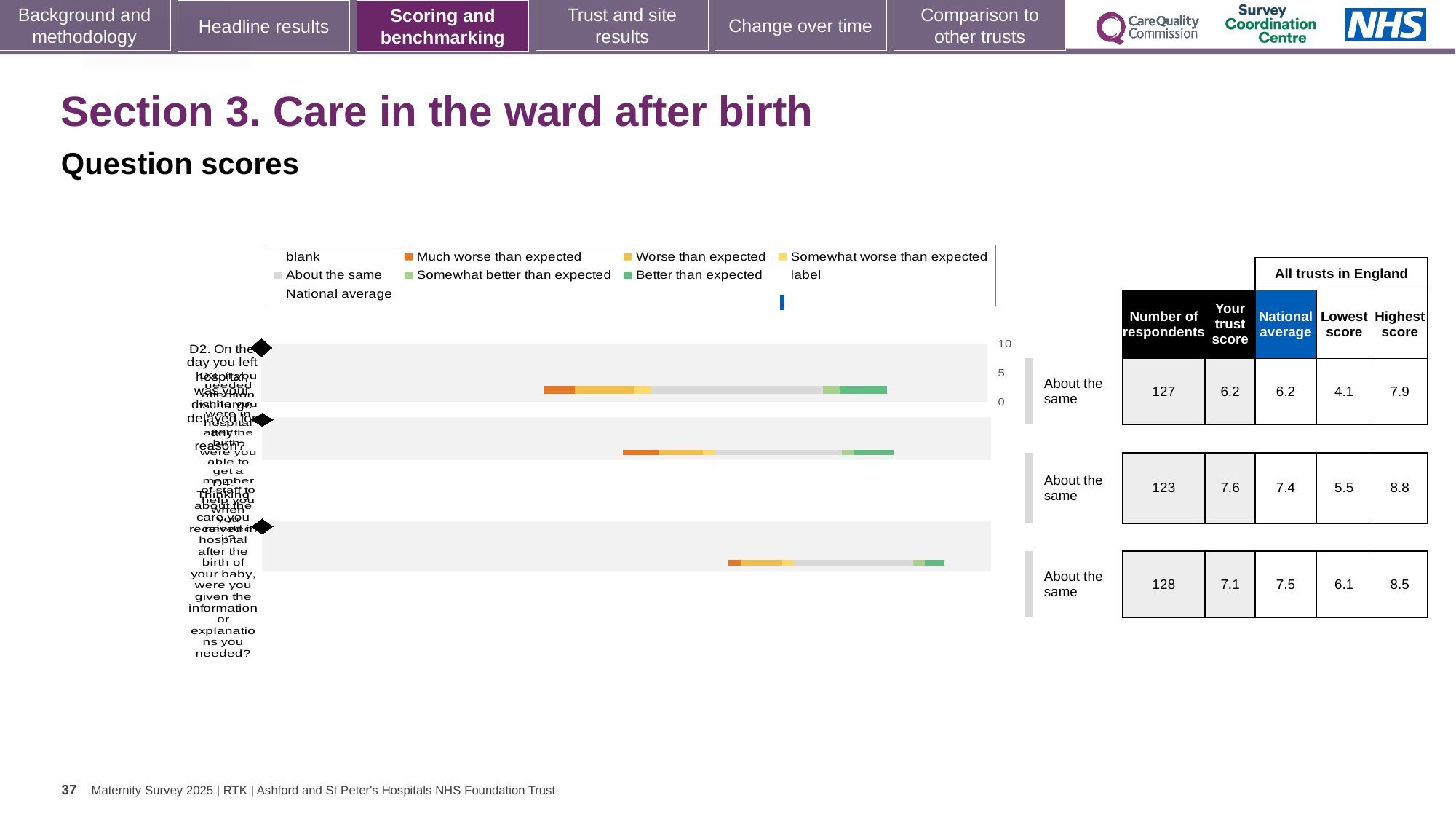
What type of chart is shown on the slide? bar chart Which row in the table beside the chart has the highest 'Highest score' value? middle row (8.8) For the middle row in the table beside the chart, which is larger: the trust score or the national average? trust score (7.6) Which row in the table beside the chart has the lowest 'Lowest score' value? top row (4.1) In the table beside the chart, what is the national average for the bottom row? 7.5 In the table beside the chart, what is the difference between the highest score and the lowest score for the bottom row? 2.4 In the table beside the chart, what is the number of respondents for the top row? 127 What colour does the legend use for 'Better than expected'? green How many question bars are plotted in the chart? 3 In the table beside the chart, what is the highest score for the top row? 7.9 In the table beside the chart, what is the 'Your trust score' value for the middle row? 7.6 What benchmark category is shown for all three questions in the chart? About the same